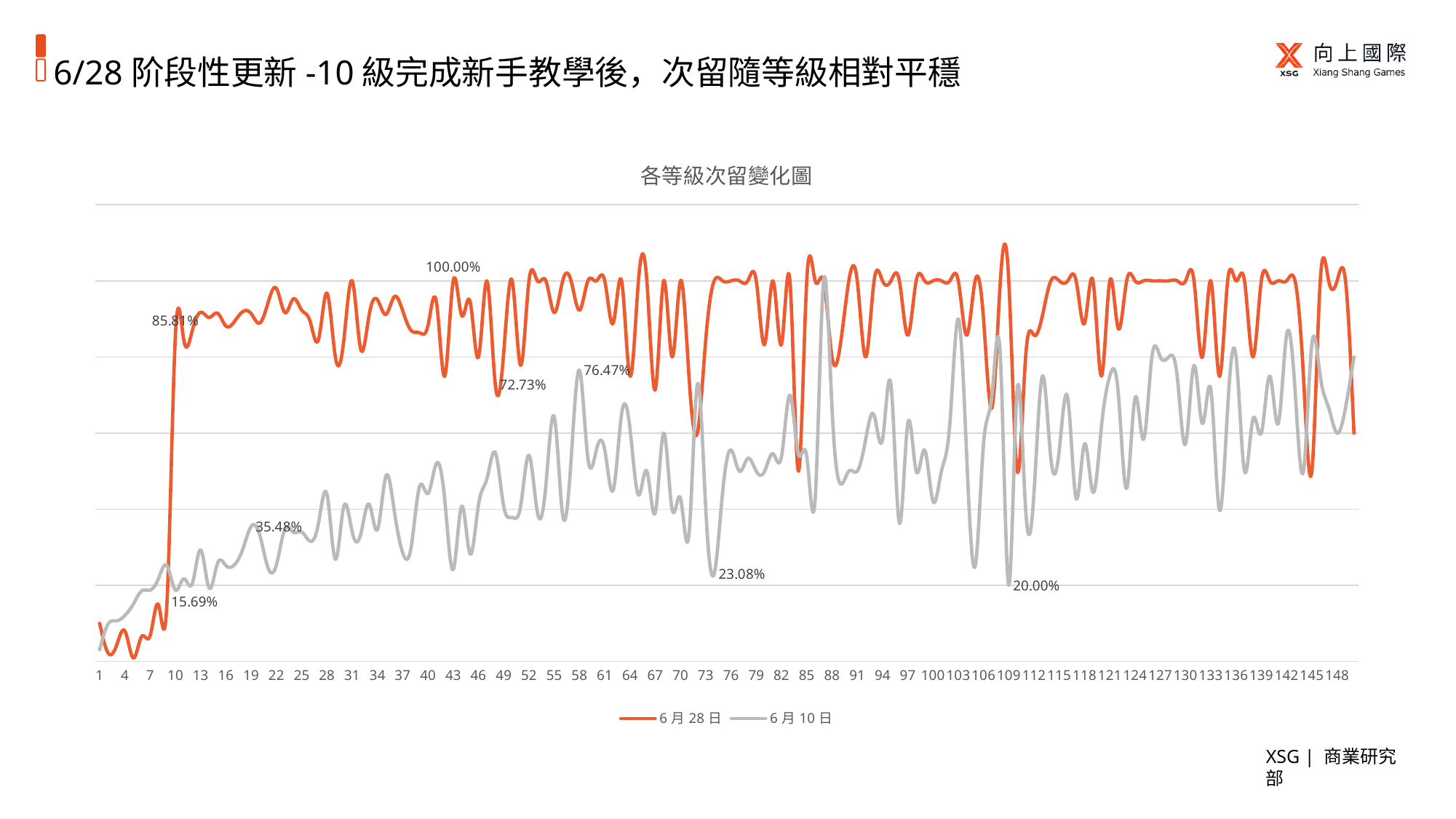
Which series does the 20.00% data label belong to? 6 月 10 日 What is the lowest value labelled on the chart? 15.69% Which series does the 100.00% data label belong to? 6 月 28 日 Which series is drawn in orange? 6 月 28 日 What kind of chart is shown on the slide? line chart Does the 6 月 10 日 series generally rise or fall as the level increases? rise Which two series are listed in the legend? 6 月 28 日 and 6 月 10 日 How many series does the legend list? 2 What is the title of the chart? 各等級次留變化圖 What is the highest value labelled on the chart? 100.00% What is the first level shown on the x axis? 1 Which series is generally higher across levels after level 10, 6 月 28 日 or 6 月 10 日? 6 月 28 日